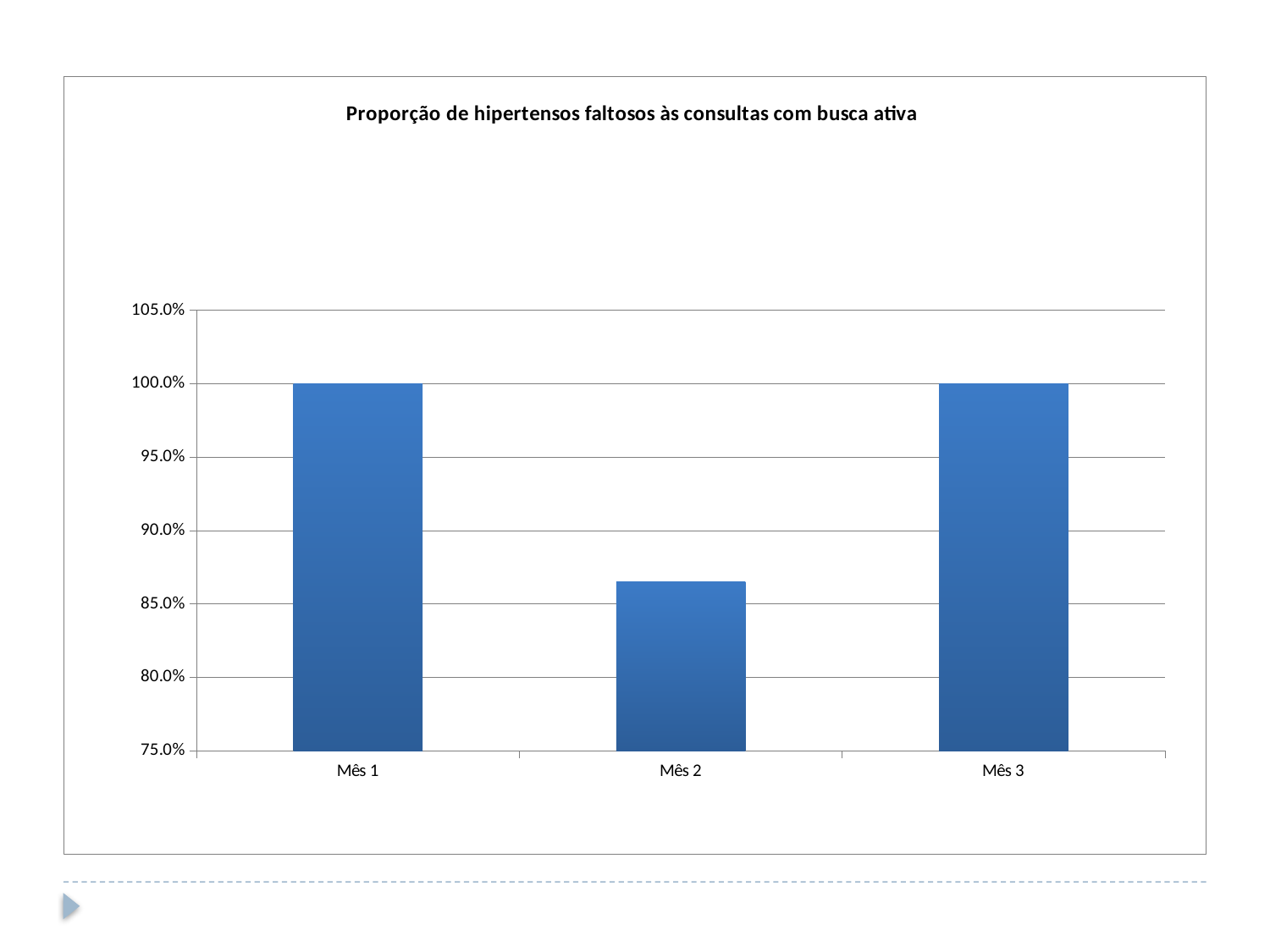
What kind of chart is shown on the slide? bar chart Which is larger, the value for Mês 2 or the value for Mês 3? Mês 3 What is the title of the chart? Proporção de hipertensos faltosos às consultas com busca ativa Which is larger, the value for Mês 1 or the value for Mês 2? Mês 1 Does the value rise or fall from Mês 2 to Mês 3? rise What is the difference between the values for Mês 1 and Mês 3? 0.0% How many months are shown on the x axis? 3 What is the value for Mês 1? 100.0% Is the value for Mês 2 greater or less than 85.0%? greater Which month has the lowest value? Mês 2 Is the value for Mês 2 greater or less than 90.0%? less What is the value for Mês 3? 100.0%